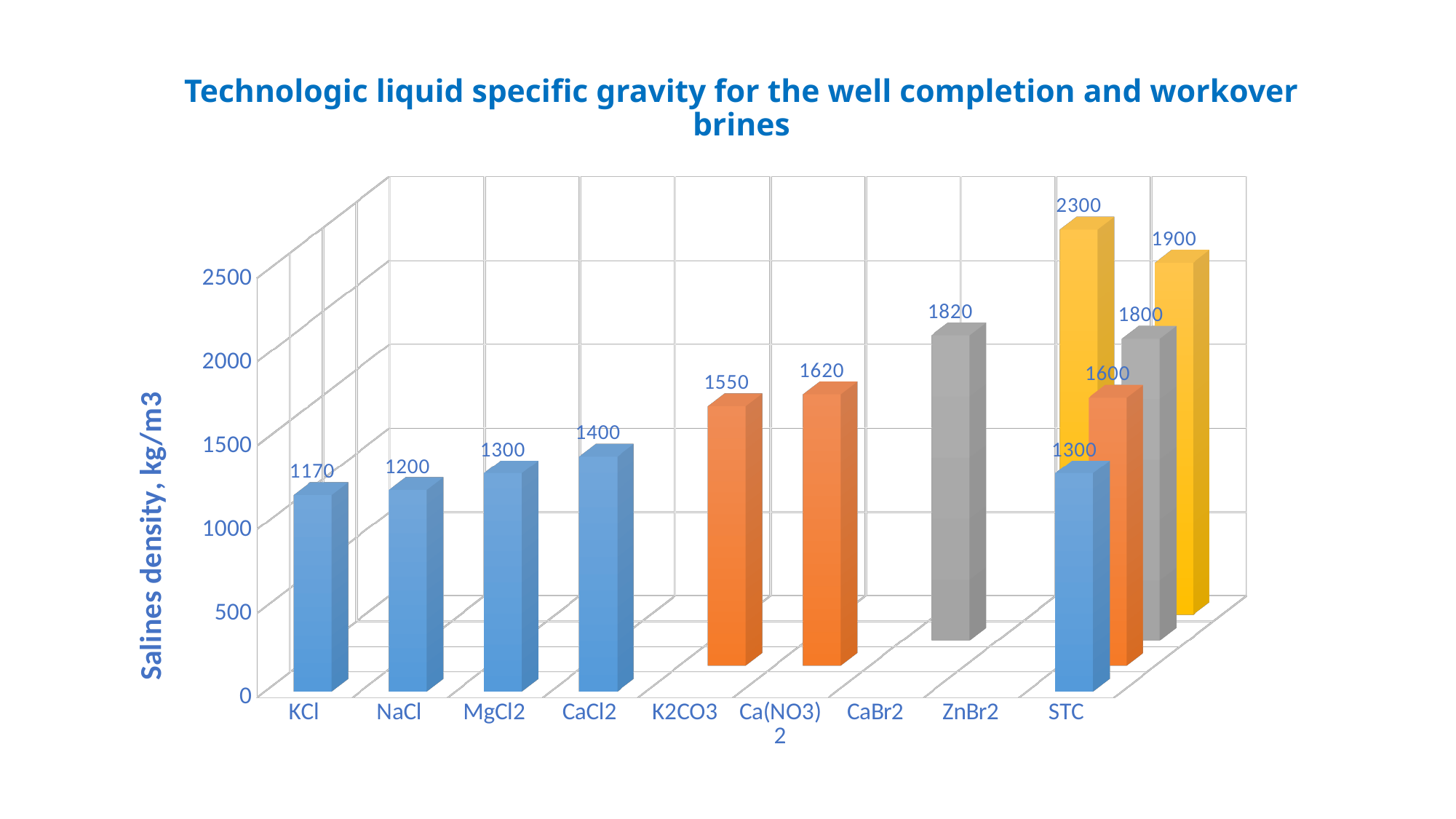
Which category has the lowest labelled value on the chart? KCl What is the label of the vertical axis? Salines density, kg/m3 How many categories are labelled on the x axis? 9 What kind of chart is shown on the slide? Bar chart What is the highest data label shown on the chart? 2300 What is the salines density value for Ca(NO3)2? 1620 What is the salines density value for K2CO3? 1550 What is the salines density value for NaCl? 1200 What is the difference between the values for CaCl2 and KCl? 230 Which has a larger value, K2CO3 or Ca(NO3)2? Ca(NO3)2 What is the salines density value for CaCl2? 1400 What is the salines density value for KCl? 1170